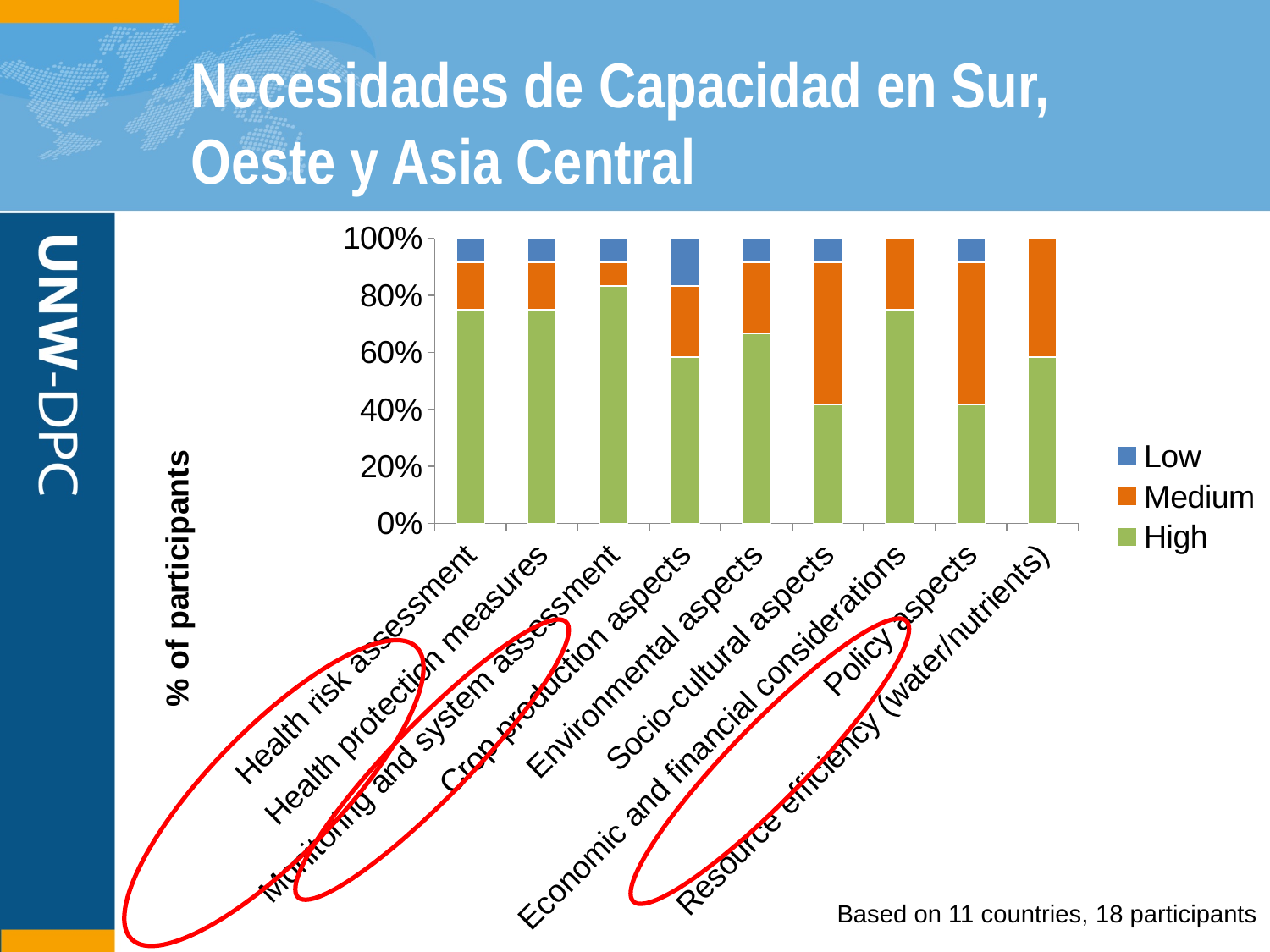
Which has a larger High segment, Monitoring and system assessment or Socio-cultural aspects? Monitoring and system assessment Which has a larger Medium segment, Policy aspects or Health risk assessment? Policy aspects Which category has the largest High segment? Monitoring and system assessment What kind of chart is shown on the slide? Stacked bar chart Is the High value for Environmental aspects greater or less than 60%? greater According to the note on the slide, how many countries and participants is the chart based on? 11 countries, 18 participants What is the label on the vertical axis of the chart? % of participants Is the High value for Monitoring and system assessment greater or less than 80%? greater How many series does the chart legend list? 3 Is the High value for Socio-cultural aspects greater or less than 60%? less How many categories are shown along the x axis of the chart? 9